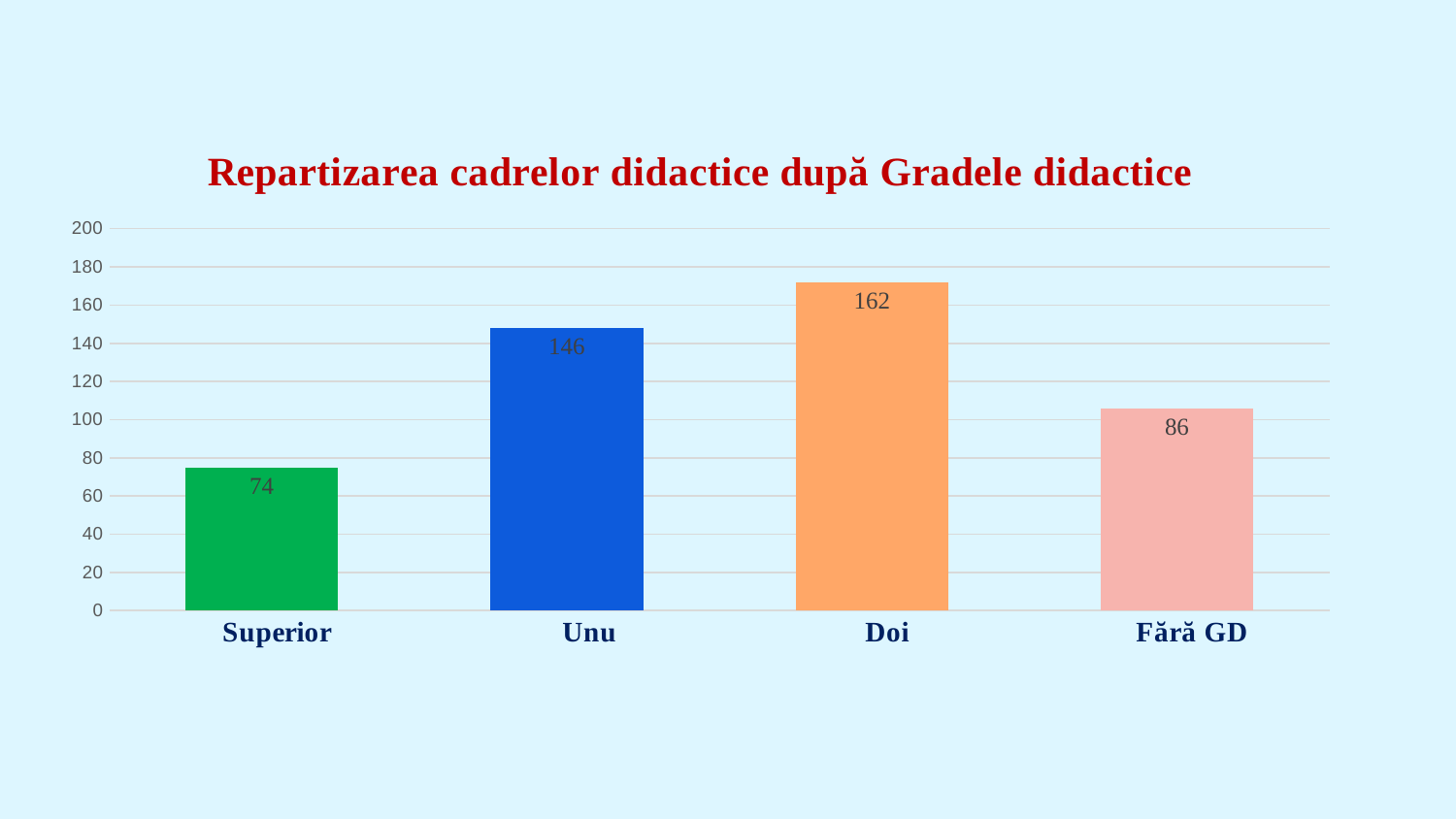
Which category has the highest value? Doi What is the value for Fără GD? 86 Which is larger, the value for Unu or the value for Fără GD? Unu What is the value for Unu? 146 What is the difference between the values for Fără GD and Superior? 12 What is the difference between the values for Doi and Unu? 16 How many categories are shown on the x axis? 4 What is the title of the chart? Repartizarea cadrelor didactice după Gradele didactice Which category has the lowest value? Superior What is the value for Superior? 74 What is the value for Doi? 162 What kind of chart is shown on the slide? bar chart